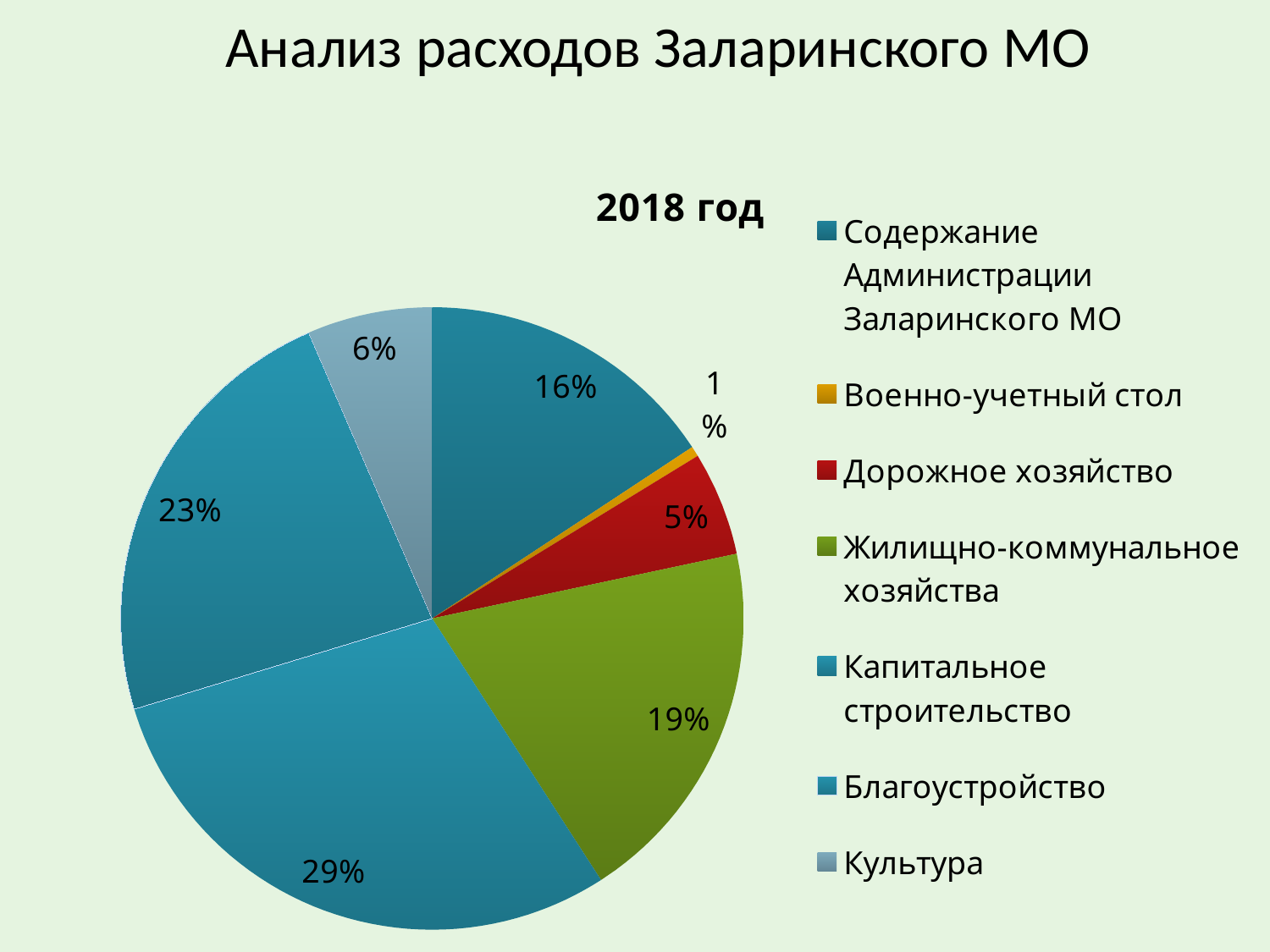
What share of expenses is Военно-учетный стол? 1% What share of expenses is Содержание Администрации Заларинского МО? 16% What is the title of the chart? 2018 год Which category has the smallest share of expenses? Военно-учетный стол What kind of chart is shown on the slide? pie chart What share of expenses is Благоустройство? 23% Which is larger, the share for Культура or the share for Дорожное хозяйство? Культура How many categories does the legend list? 7 Which category has the largest share of expenses? Капитальное строительство What is the difference in percentage points between Капитальное строительство and Благоустройство? 6